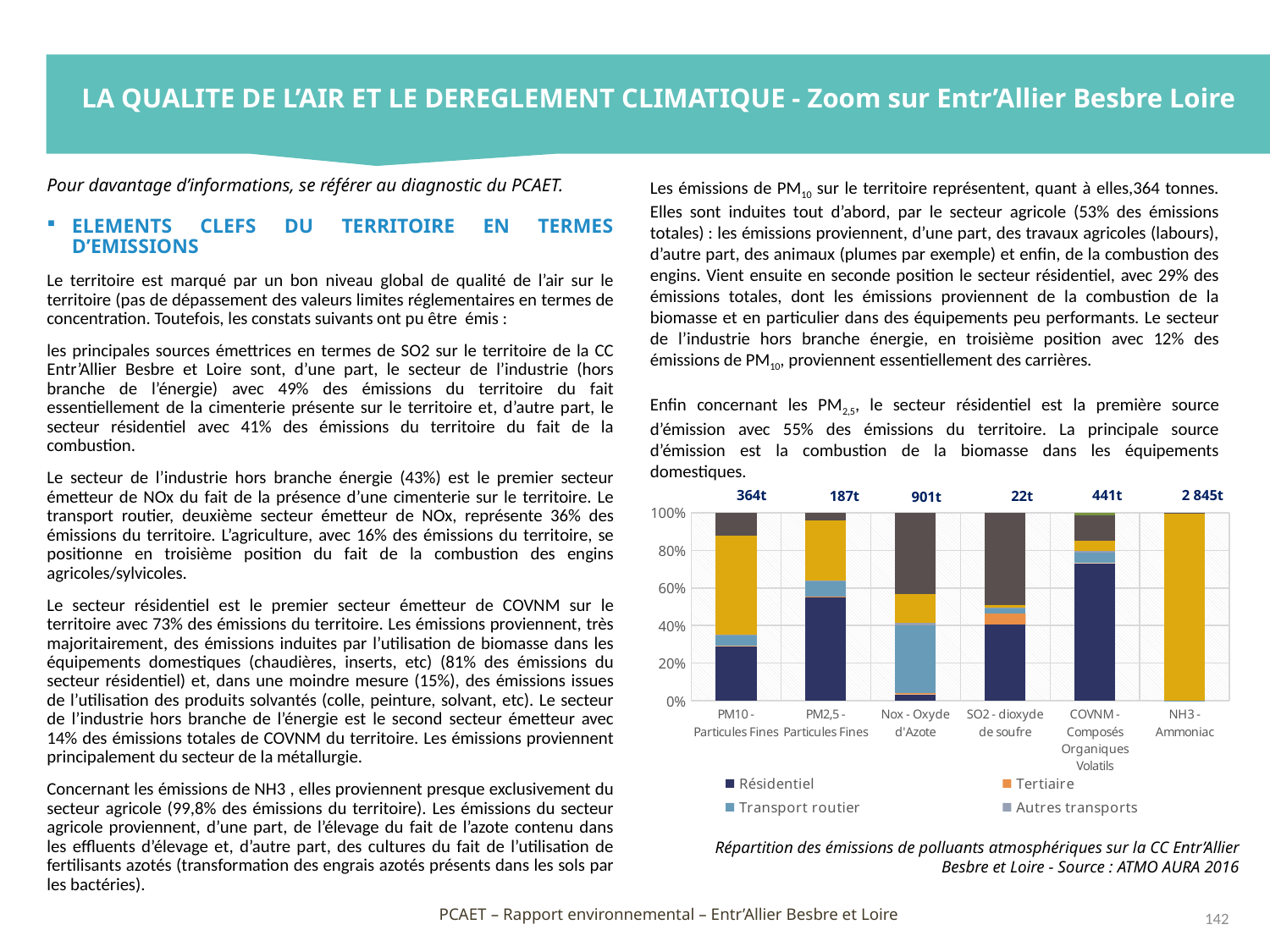
Which pollutant has the highest total tonnage printed above its bar? NH3 - Ammoniac What total tonnage is printed above the NH3 - Ammoniac bar? 2 845t What total tonnage is printed above the COVNM - Composés Organiques Volatils bar? 441t What is the difference between the total tonnage printed for Nox - Oxyde d'Azote and for PM10 - Particules Fines? 537t According to the caption, what is the source of the chart data? ATMO AURA 2016 Which pollutant has the lowest total tonnage printed above its bar? SO2 - dioxyde de soufre Is the Résidentiel share of the COVNM - Composés Organiques Volatils bar greater or less than 60%? greater Which has a larger total tonnage printed above its bar, PM10 - Particules Fines or PM2,5 - Particules Fines? PM10 - Particules Fines How many series does the chart's legend list? 4 What total tonnage is printed above the PM10 - Particules Fines bar? 364t What kind of chart is shown on the slide? Stacked bar chart How many pollutant categories are shown on the x axis of the chart? 6